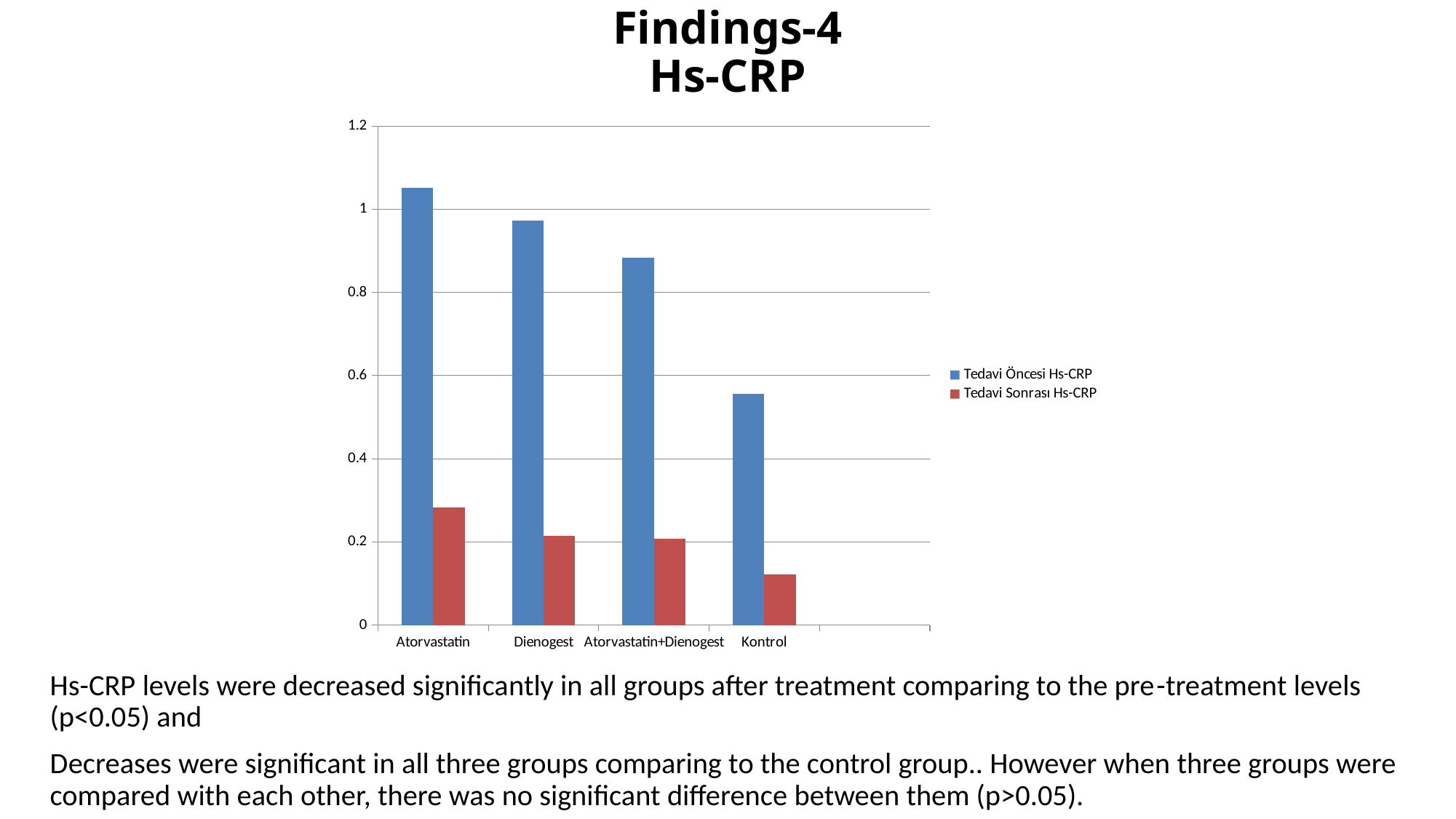
Do the Tedavi Öncesi Hs-CRP values rise or fall from Atorvastatin to Kontrol along the x axis? fall What kind of chart is shown on the slide? bar chart Which group has the lowest Tedavi Sonrası Hs-CRP value? Kontrol Which is larger for Dienogest: the Tedavi Öncesi Hs-CRP value or the Tedavi Sonrası Hs-CRP value? Tedavi Öncesi Hs-CRP Is the Tedavi Öncesi Hs-CRP value for Kontrol greater or less than 0.4? greater Which group has the highest Tedavi Öncesi Hs-CRP value? Atorvastatin Is the Tedavi Sonrası Hs-CRP value for Kontrol greater or less than 0.2? less Which group has the lowest Tedavi Öncesi Hs-CRP value? Kontrol Which group has the highest Tedavi Sonrası Hs-CRP value? Atorvastatin How many groups are shown on the x axis? 4 Is the Tedavi Öncesi Hs-CRP value for Atorvastatin greater or less than 1? greater How many series does the legend list? 2